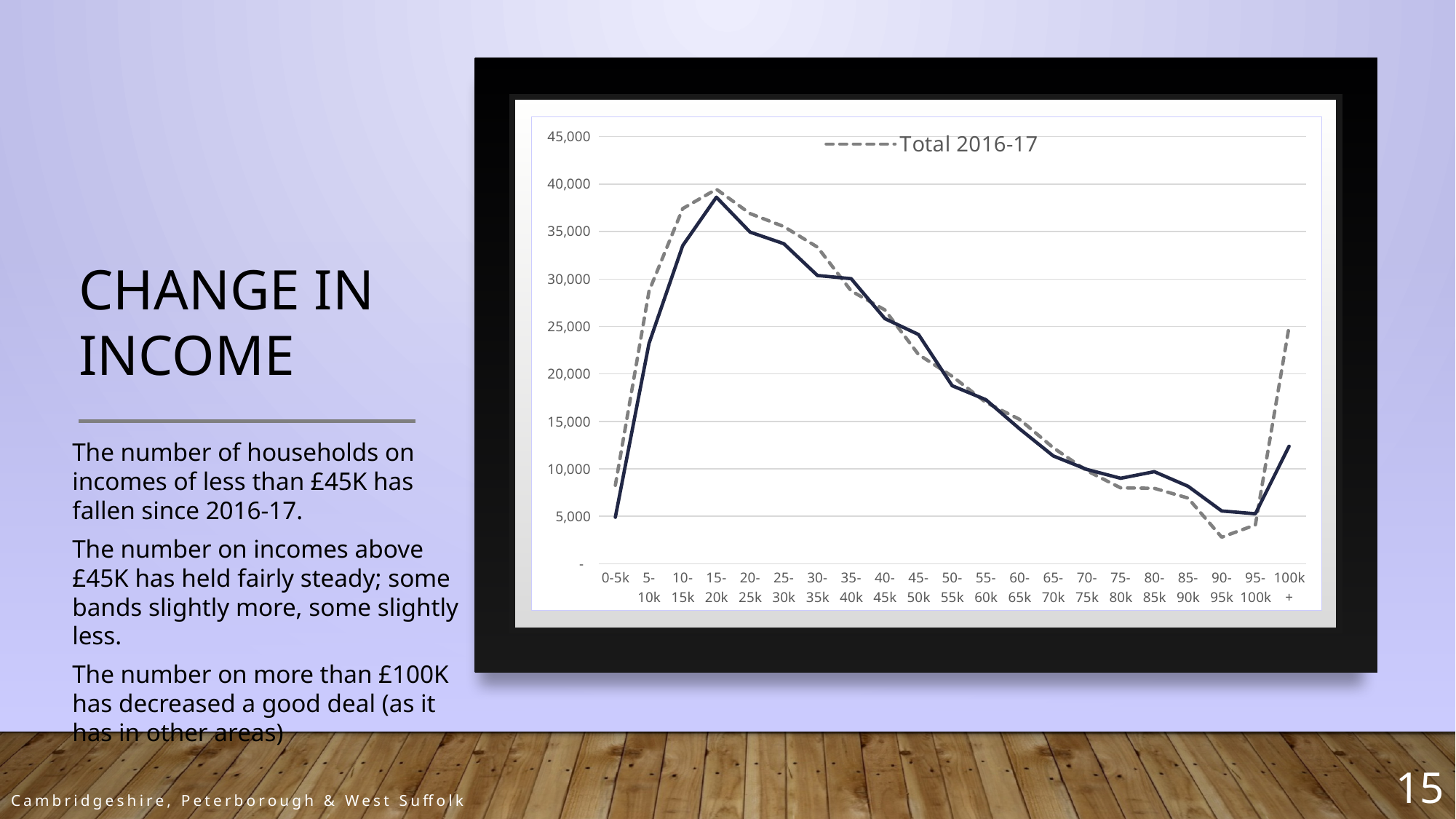
In which income band does the solid dark line reach its highest value? 15-20k How many series does the chart's legend list? 1 Is the value of the solid dark line for the 100k+ band greater or less than 10,000? greater For the 100k+ band, which line is higher: the dashed Total 2016-17 line or the solid dark line? the dashed Total 2016-17 line Does the solid dark line generally rise or fall from the 15-20k band to the 95-100k band? fall How many income bands are shown along the x axis of the chart? 21 What kind of chart is shown on the slide? line chart Is the value of the solid dark line for the 15-20k band greater or less than 35,000? greater Is the value of the solid dark line for the 50-55k band greater or less than 20,000? less What is the series name shown in the chart's legend? Total 2016-17 In which income band does the dashed Total 2016-17 line reach its lowest value? 90-95k